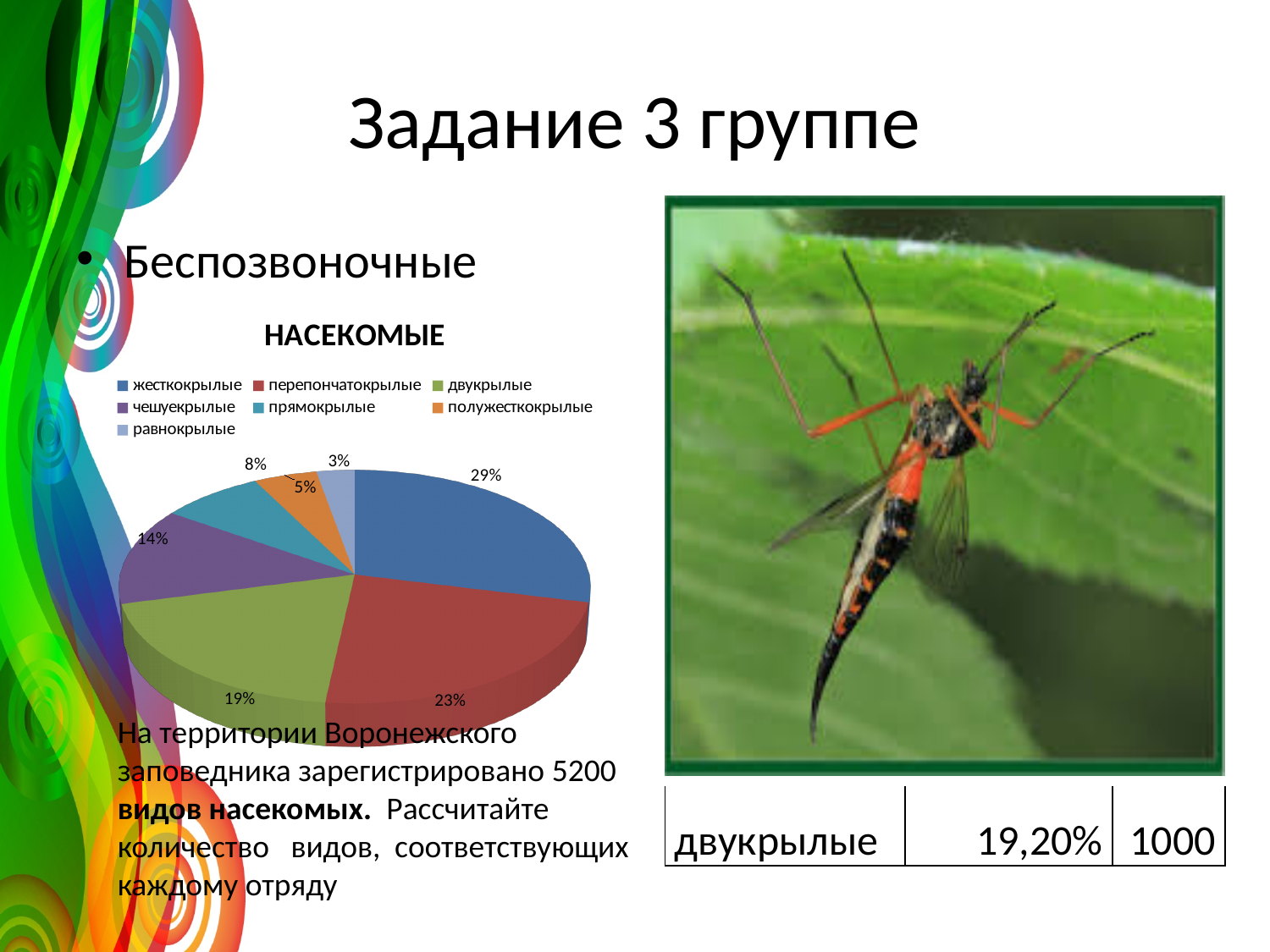
Which category has the largest share of the pie? жесткокрылые Which has a larger share, прямокрылые or полужесткокрылые? прямокрылые What share of the pie does жесткокрылые have? 29% What is the title of the chart? НАСЕКОМЫЕ How many slices does the pie chart have? 7 What is the difference between the shares of жесткокрылые and двукрылые? 10% What type of chart is shown on the slide? pie chart What share of the pie does перепончатокрылые have? 23% What share of the pie does чешуекрылые have? 14% Which category has the smallest share of the pie? равнокрылые What share of the pie does двукрылые have? 19% How many categories does the legend of the chart list? 7